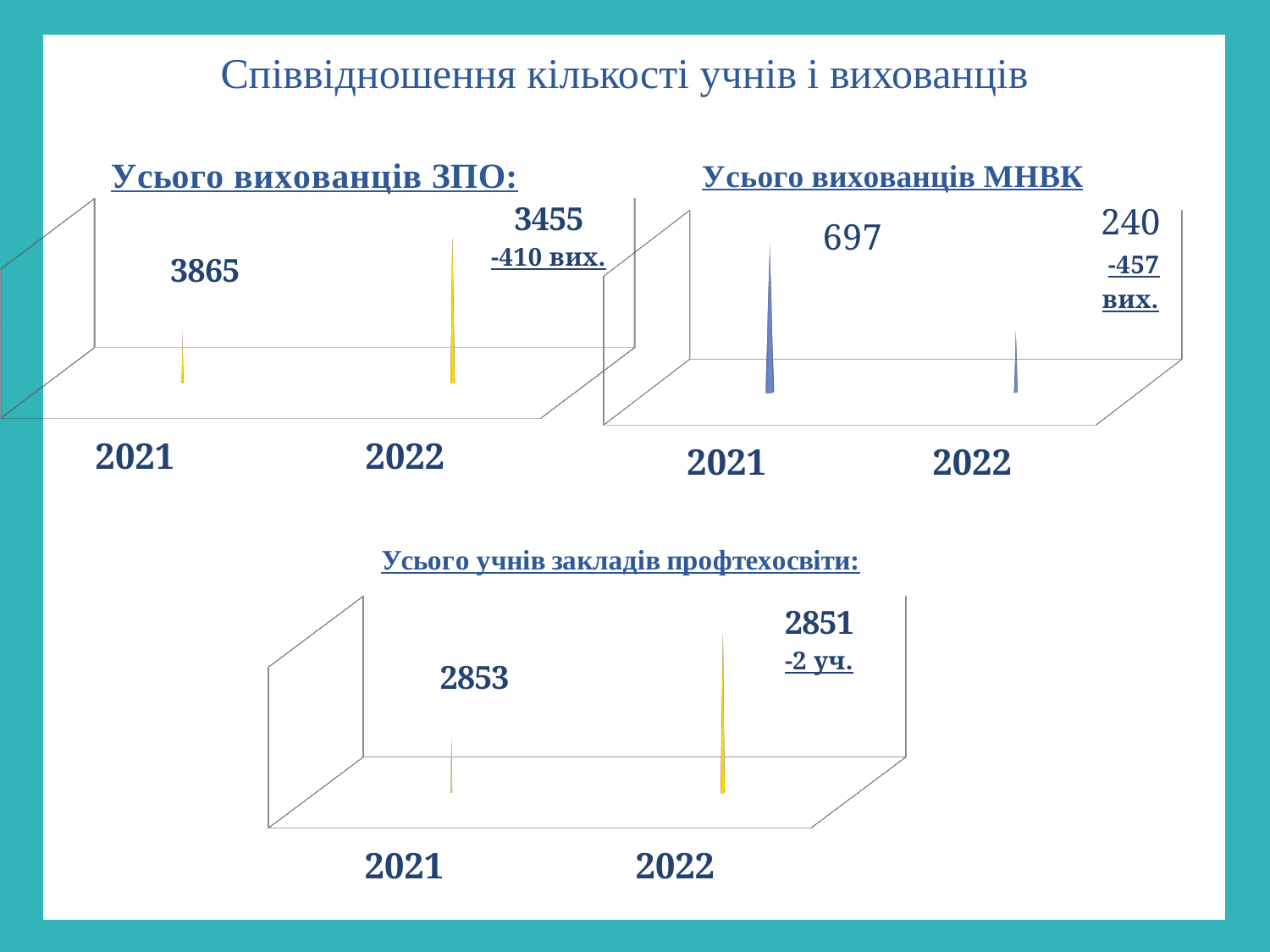
How many charts are shown on the slide? 3 In the chart titled "Усього вихованців ЗПО:", what is the value for 2021? 3865 In the chart titled "Усього вихованців ЗПО:", what is the value for 2022? 3455 In the chart titled "Усього вихованців МНВК", by how much did the value drop from 2021 to 2022? 457 In the chart titled "Усього учнів закладів профтехосвіти:", what is the value for 2022? 2851 In the chart titled "Усього учнів закладів профтехосвіти:", what is the value for 2021? 2853 In the chart titled "Усього учнів закладів профтехосвіти:", what is the difference between the 2021 and 2022 values? 2 In the chart titled "Усього вихованців МНВК", which year has the lower value? 2022 In the chart titled "Усього вихованців МНВК", what is the value for 2022? 240 In the chart titled "Усього вихованців ЗПО:", what is the difference between the 2021 and 2022 values? 410 In the chart titled "Усього вихованців МНВК", what is the value for 2021? 697